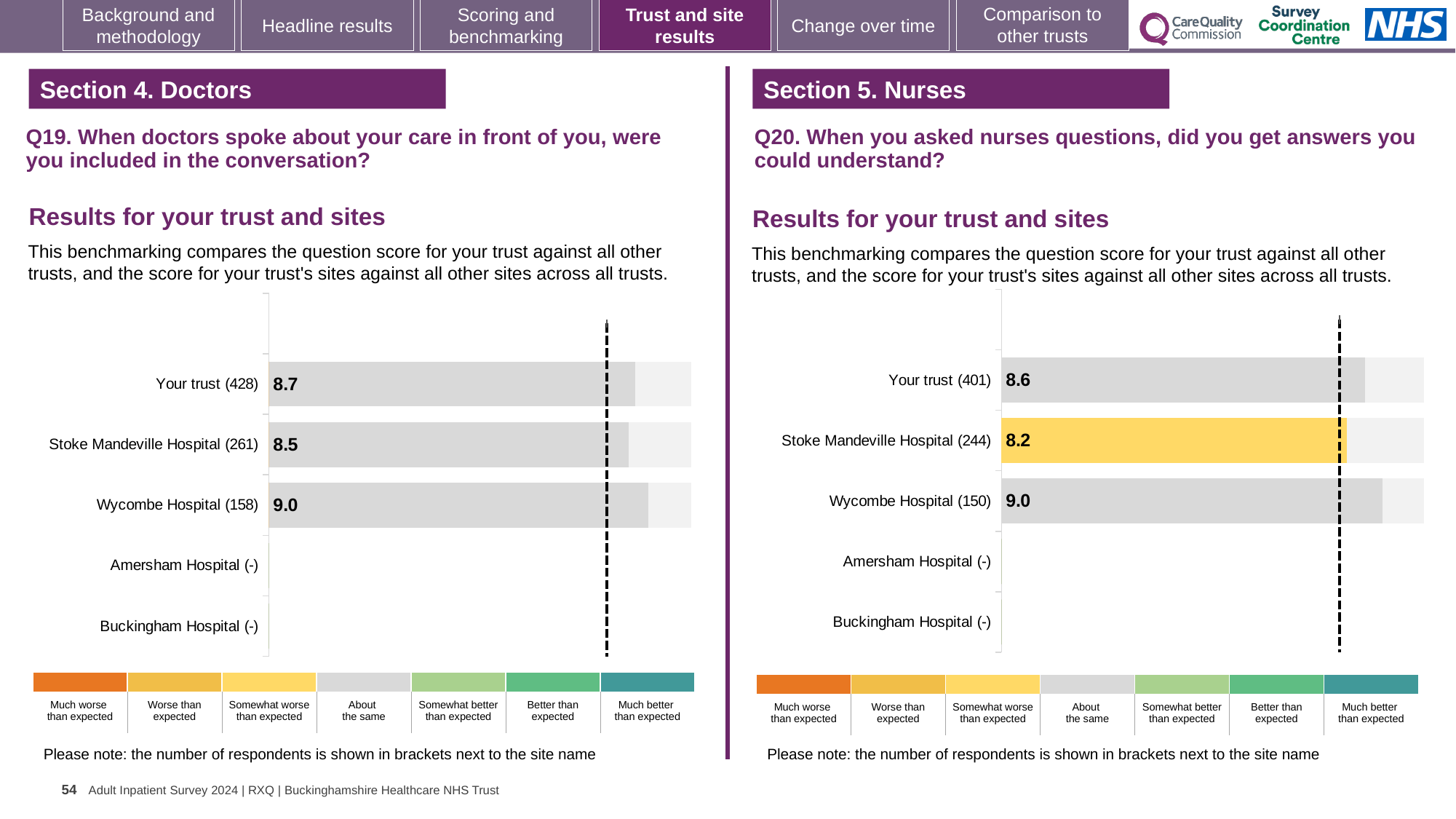
In the Q20 chart on the right, what is the score for Stoke Mandeville Hospital (244)? 8.2 What type of chart is used in the Q20 chart on the right? Bar chart In the Q20 chart on the right, which site's bar is coloured yellow (somewhat worse than expected)? Stoke Mandeville Hospital (244) In the Q19 chart on the left, what is the score for Wycombe Hospital (158)? 9.0 In the Q19 chart on the left, what is the score for Your trust (428)? 8.7 In the Q19 chart on the left, which site or trust has the highest score? Wycombe Hospital (158) In the Q19 chart on the left, how many sites or trusts are listed on the vertical axis? 5 In the Q19 chart on the left, what is the difference between the scores for Wycombe Hospital and Stoke Mandeville Hospital? 0.5 In the Q20 chart on the right, which site or trust has the lowest score among those with a value shown? Stoke Mandeville Hospital (244) In the Q20 chart on the right, which has the higher score: Your trust (401) or Wycombe Hospital (150)? Wycombe Hospital (150) In the Q20 chart on the right, what is the difference between the scores for Your trust and Stoke Mandeville Hospital? 0.4 In the Q20 chart on the right, what is the score for Your trust (401)? 8.6